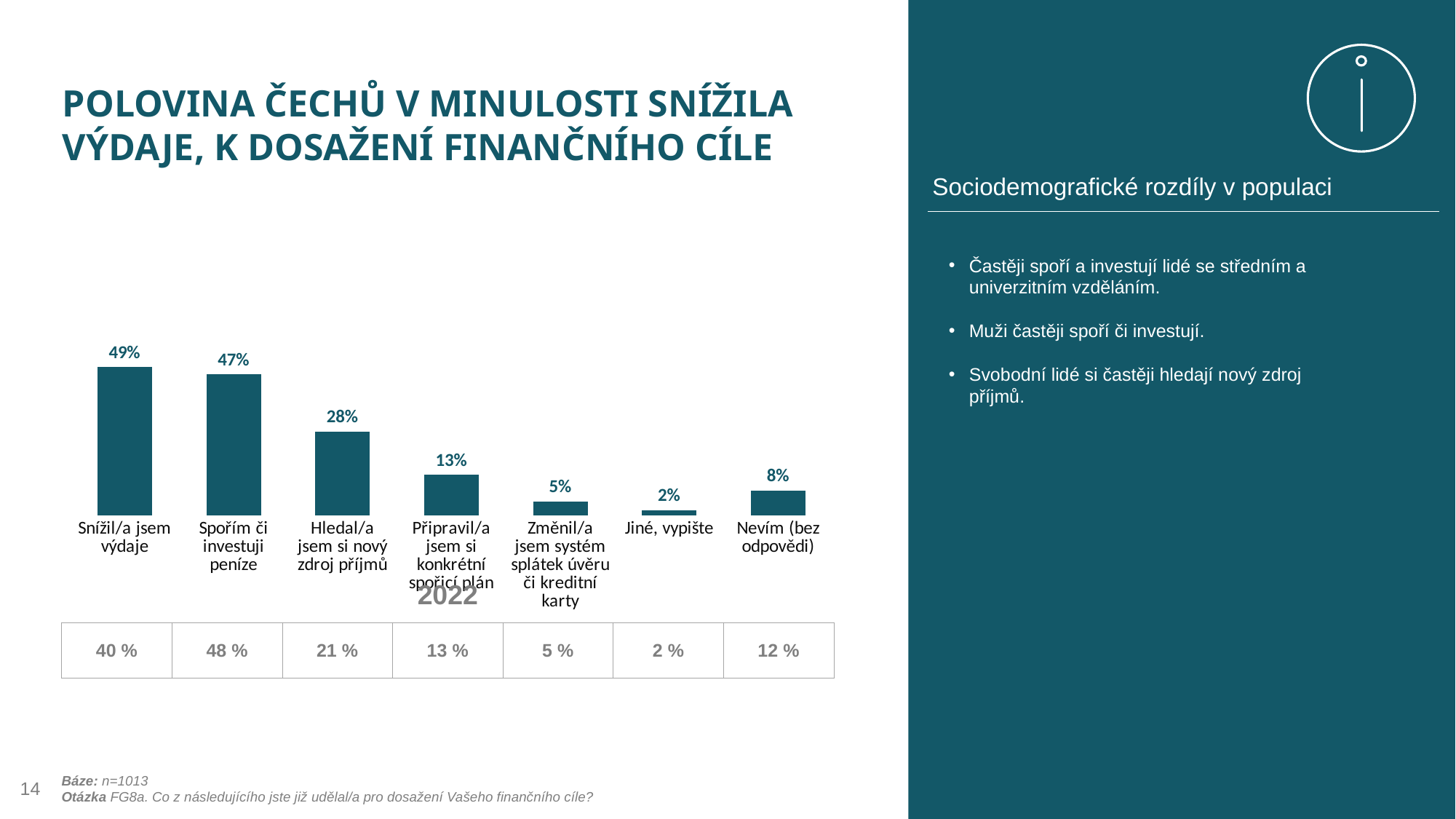
What is the difference between the values for "Snížil/a jsem výdaje" and "Spořím či investuji peníze"? 2 percentage points How many categories are shown in the chart? 7 What is the value shown for "Hledal/a jsem si nový zdroj příjmů"? 28% What colour are the bars in the chart? Dark teal Which is larger: the value for "Nevím (bez odpovědi)" or for "Změnil/a jsem systém splátek úvěru či kreditní karty"? Nevím (bez odpovědi) What is the difference between the values for "Hledal/a jsem si nový zdroj příjmů" and "Připravil/a jsem si konkrétní spořicí plán"? 15 percentage points What is the value shown for "Nevím (bez odpovědi)"? 8% What percentage of respondents said "Snížil/a jsem výdaje"? 49% Which category has the lowest value in the chart? Jiné, vypište Which category has the highest value in the chart? Snížil/a jsem výdaje What is the value shown for "Připravil/a jsem si konkrétní spořicí plán"? 13% What type of chart is shown on the slide? Bar chart